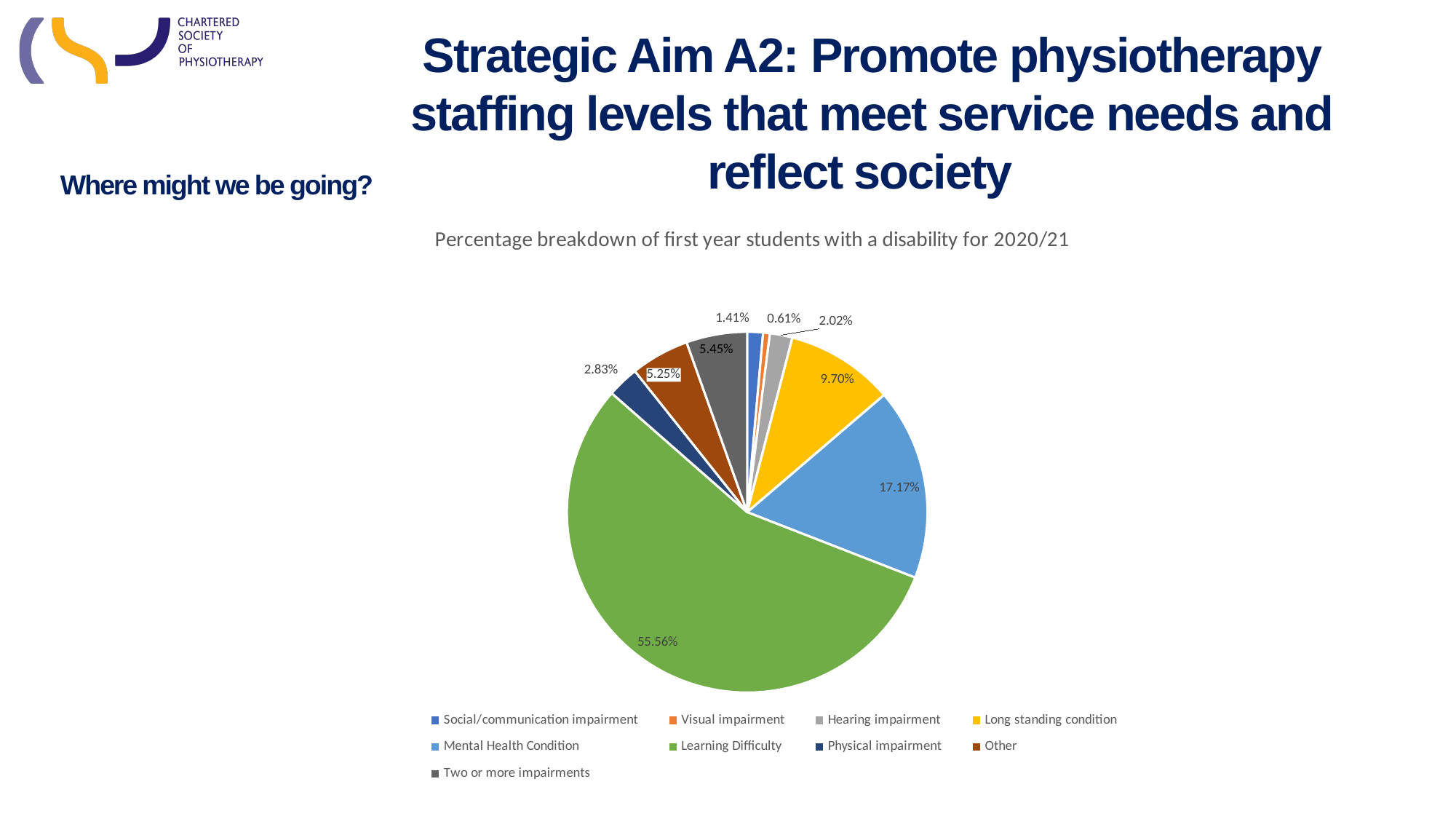
What colour is the Learning Difficulty slice? Green What percentage of the pie is Visual impairment? 0.61% Which is larger, the share for Two or more impairments or the share for Other? Two or more impairments Which category has the smallest share of the pie? Visual impairment Which category has the largest share of the pie? Learning Difficulty What kind of chart is shown on the slide? Pie chart How many categories does the legend list? 9 What percentage of the pie is Long standing condition? 9.70% What percentage of the pie is Mental Health Condition? 17.17% What is the title of the chart? Percentage breakdown of first year students with a disability for 2020/21 What is the difference between the Mental Health Condition share and the Long standing condition share? 7.47% What percentage of the pie is Learning Difficulty? 55.56%